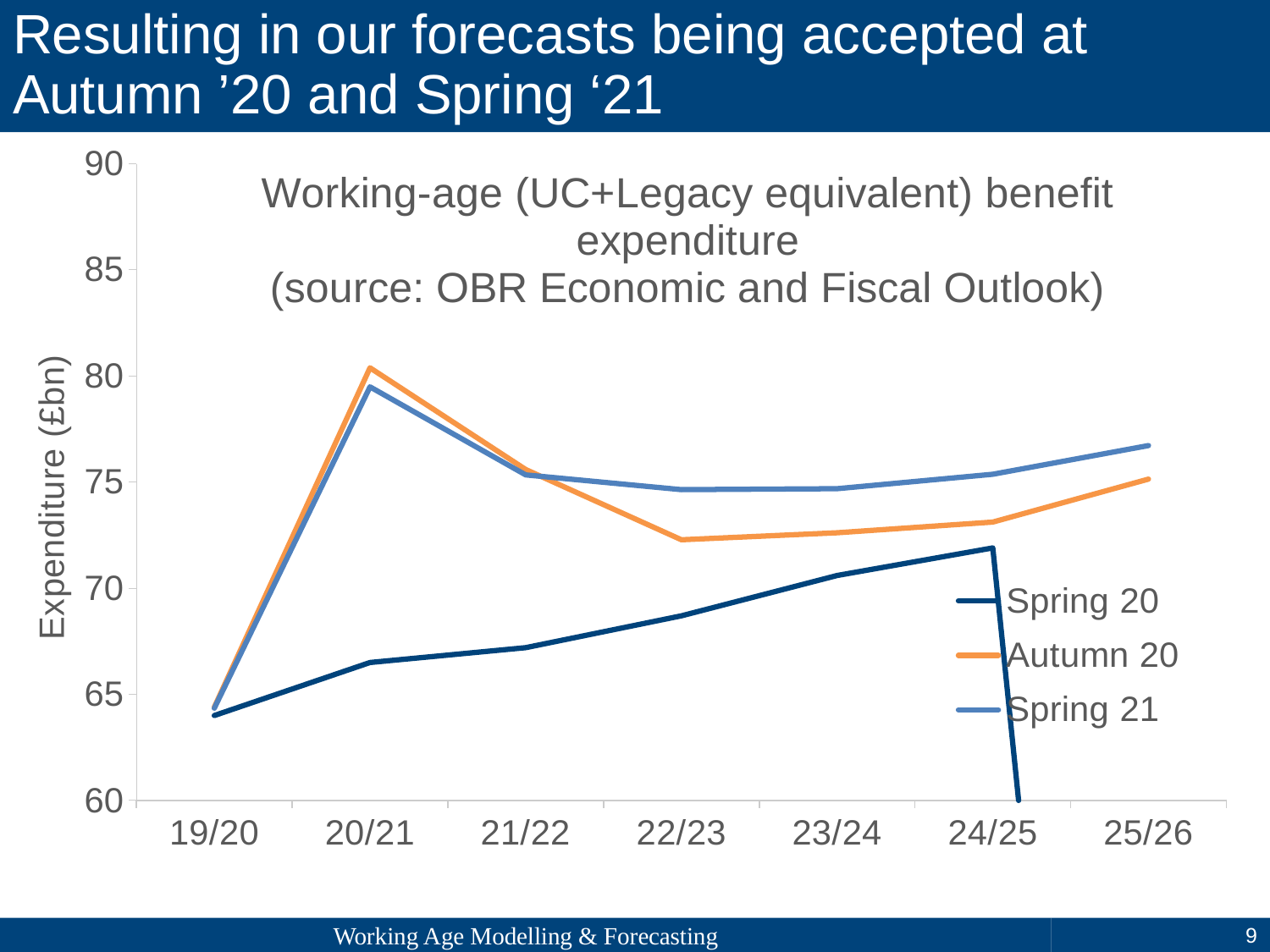
Does the Spring 20 series rise or fall from 19/20 to 24/25? Rise Is the Autumn 20 value for 22/23 greater or less than 75? less In which year does the Autumn 20 series reach its highest value? 20/21 Is the Spring 20 value for 19/20 greater or less than 65? less Is the Autumn 20 value for 20/21 greater or less than 75? greater At 24/25, which series is higher: Spring 21 or Autumn 20? Spring 21 At 22/23, which series is higher: Spring 20 or Autumn 20? Autumn 20 What kind of chart is shown on the slide? Line chart How many series does the legend list? 3 How many financial years are shown along the x axis? 7 What is the label on the y axis? Expenditure (£bn)